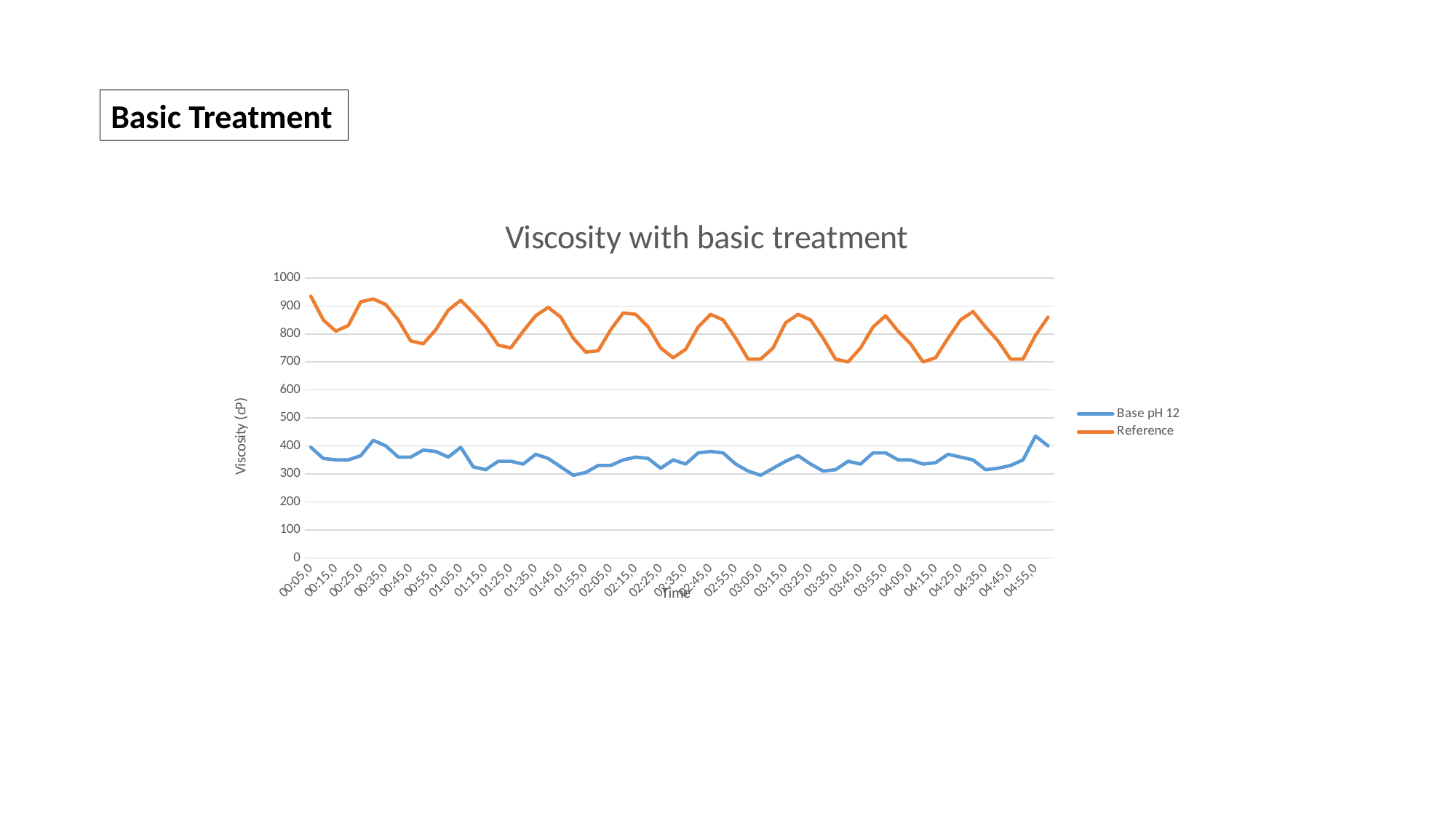
Is the Base pH 12 value at 02:25,0 greater or less than 400? less What is the label of the vertical axis? Viscosity (cP) Does the Reference series show a steady rise, a steady fall, or repeated oscillation along the time axis? Repeated oscillation How many series does the legend list? 2 Which series has the higher viscosity values throughout the chart, Base pH 12 or Reference? Reference Is the Base pH 12 value at 04:45,0 greater or less than 400? less Is the Reference value at 00:05,0 greater or less than 900? greater At 01:05,0, which series has the larger value, Base pH 12 or Reference? Reference What is the title of the chart? Viscosity with basic treatment What kind of chart is shown on the slide? Line chart